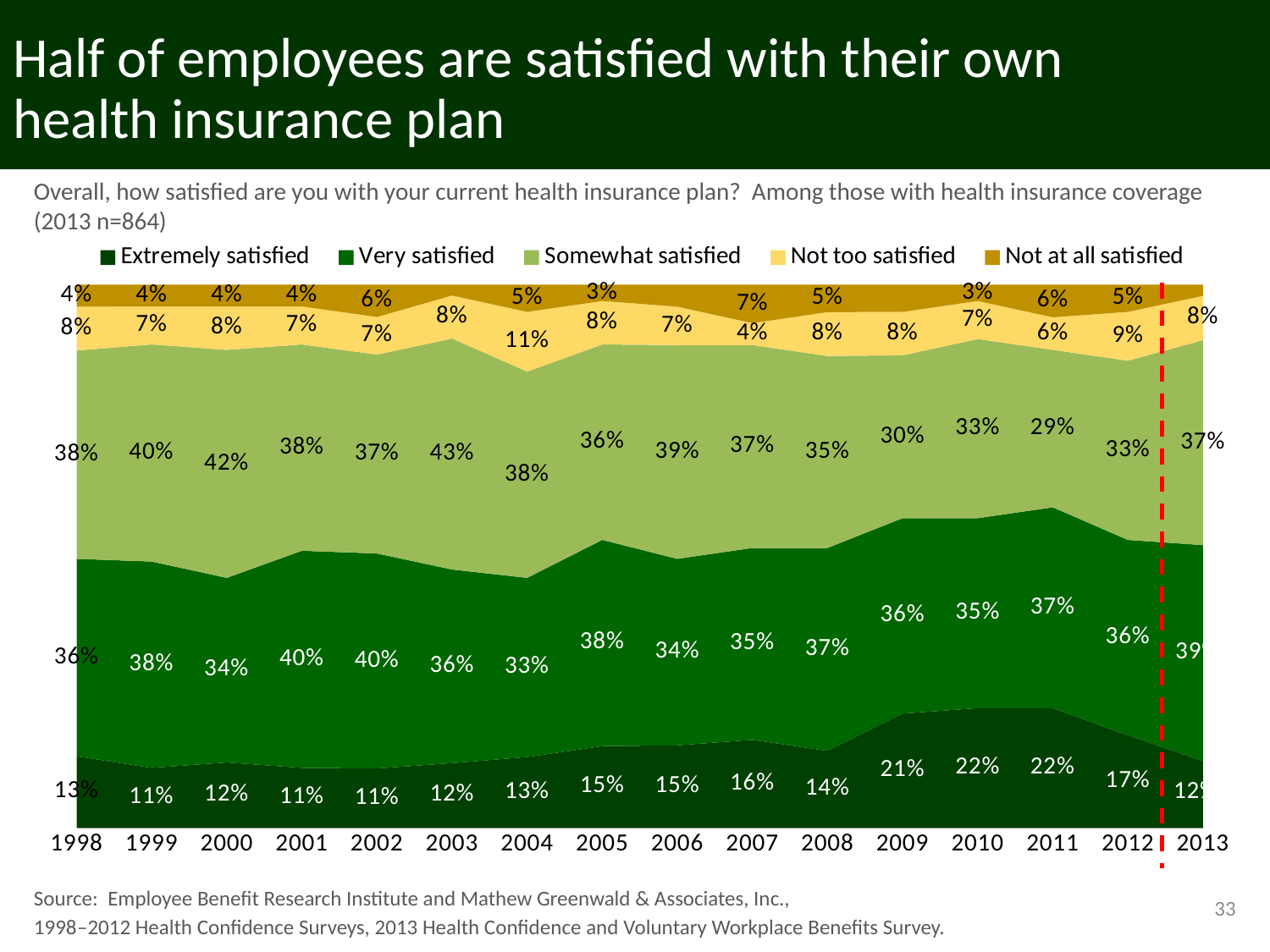
What percentage of employees were somewhat satisfied in 2003? 43% Which was larger in 2007: the 'Not too satisfied' share or the 'Not at all satisfied' share? Not at all satisfied (7%) What is the difference between the 'Extremely satisfied' share in 2011 and in 2012? 5 percentage points What percentage of employees were very satisfied in 2001? 40% How many years are shown along the x axis? 16 In which year was the 'Extremely satisfied' share lowest among the labelled values? 1999, 2001 and 2002 (11%) What kind of chart is shown on the slide? Stacked area chart What percentage of employees were not too satisfied in 2004? 11% In which year was the 'Somewhat satisfied' share lowest? 2011 Which series is shown in the lightest yellow colour in the legend? Not too satisfied How many series does the legend list? 5 What percentage of employees were extremely satisfied in 2010? 22%